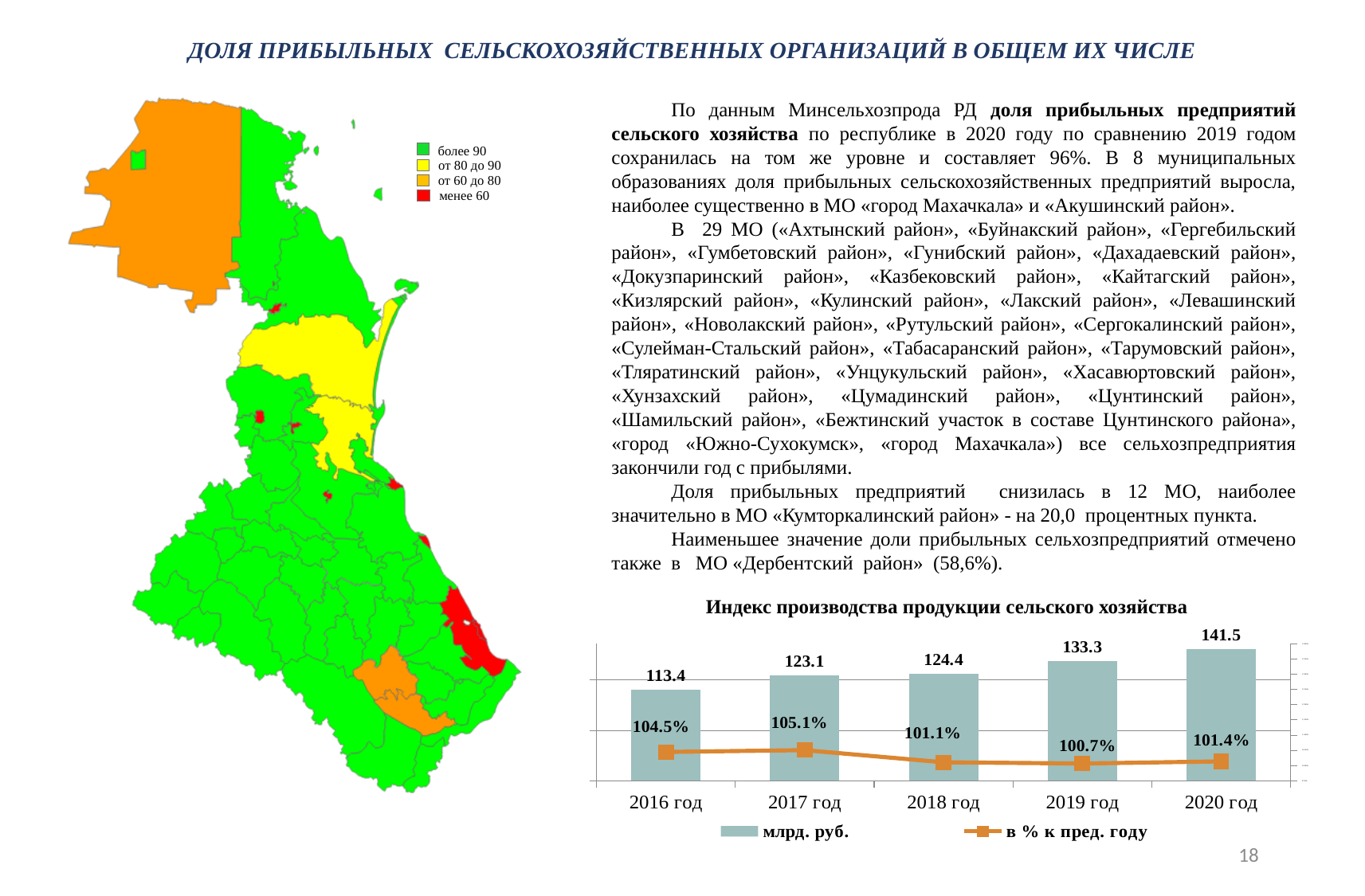
In the chart "Индекс производства продукции сельского хозяйства", how many years are shown on the x axis? 5 In the chart "Индекс производства продукции сельского хозяйства", which is larger: the "млрд. руб." value for 2018 год or for 2017 год? 2018 год In the chart "Индекс производства продукции сельского хозяйства", which series is drawn as a line with markers? в % к пред. году In the chart "Индекс производства продукции сельского хозяйства", which year has the lowest value of the "в % к пред. году" series? 2019 год In the chart "Индекс производства продукции сельского хозяйства", what is the value of the "в % к пред. году" series for 2017 год? 105.1% In the chart "Индекс производства продукции сельского хозяйства", do the "млрд. руб." values rise or fall from 2016 год to 2020 год? Rise In the chart "Индекс производства продукции сельского хозяйства", what is the difference between the "млрд. руб." values for 2020 год and 2019 год? 8.2 In the chart "Индекс производства продукции сельского хозяйства", what is the value of the "млрд. руб." series for 2016 год? 113.4 In the chart "Индекс производства продукции сельского хозяйства", how many series does the legend list? 2 In the chart "Индекс производства продукции сельского хозяйства", which year has the highest value of the "млрд. руб." series? 2020 год In the chart "Индекс производства продукции сельского хозяйства", what is the value of the "млрд. руб." series for 2020 год? 141.5 What kind of chart is "Индекс производства продукции сельского хозяйства"? Combined bar and line chart